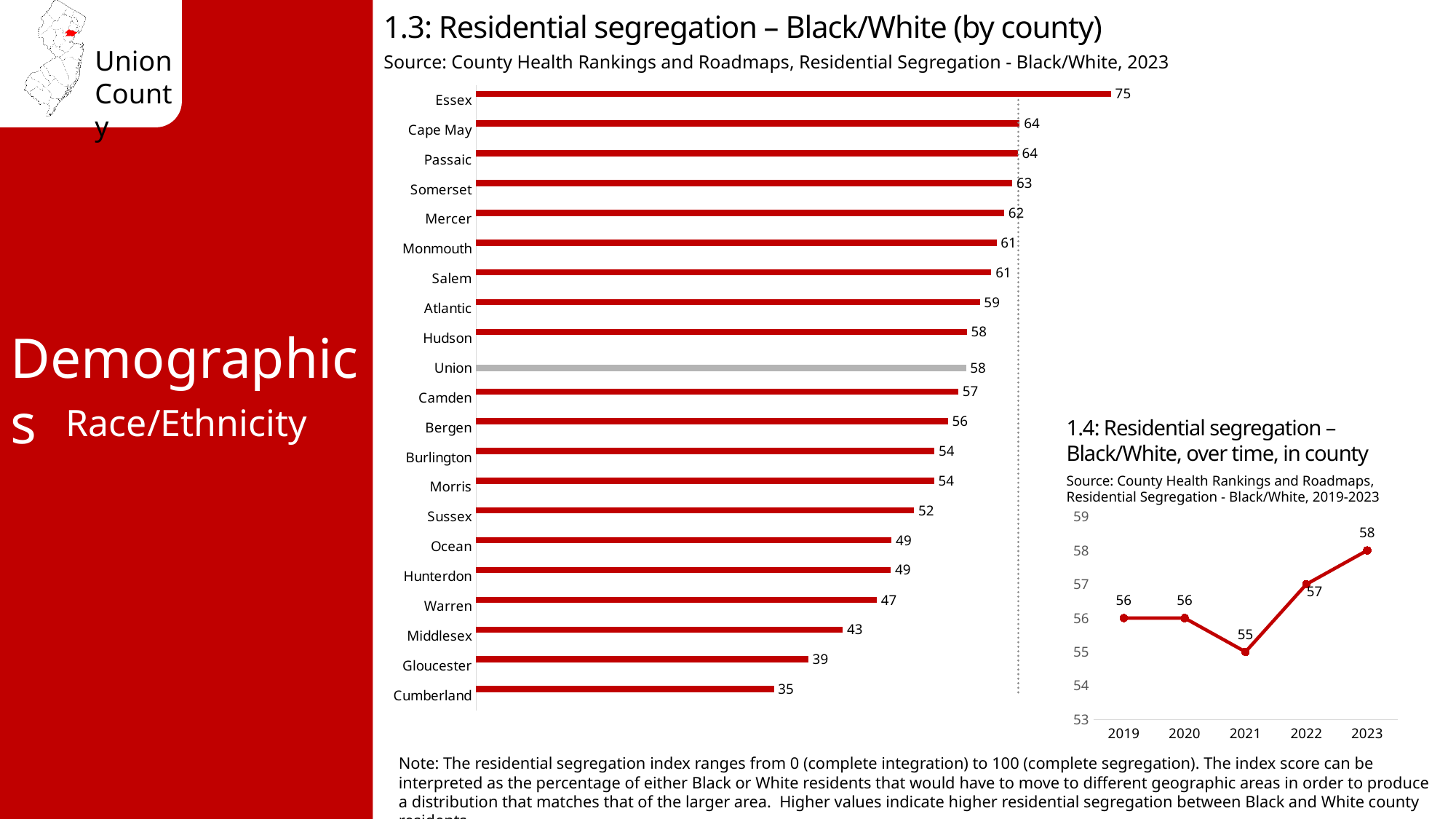
In chart 1.4 (over time, in county), which year has the highest value? 2023 In chart 1.3 (by county), which is larger, the value for Middlesex or the value for Gloucester? Middlesex In chart 1.3 (by county), what is the difference between Essex and Cumberland? 40 What kind of chart is chart 1.4 (over time, in county)? Line chart What kind of chart is chart 1.3 (by county)? Bar chart In chart 1.3 (by county), which county has the lowest value? Cumberland In chart 1.3 (by county), how many counties are shown? 21 In chart 1.3 (by county), which county has the highest value? Essex In chart 1.3 (Residential segregation – Black/White by county), what is the value for Union? 58 In chart 1.4 (over time, in county), what is the value for 2021? 55 In chart 1.3 (by county), what is the value for Mercer? 62 In chart 1.4 (over time, in county), what is the difference between 2023 and 2021? 3